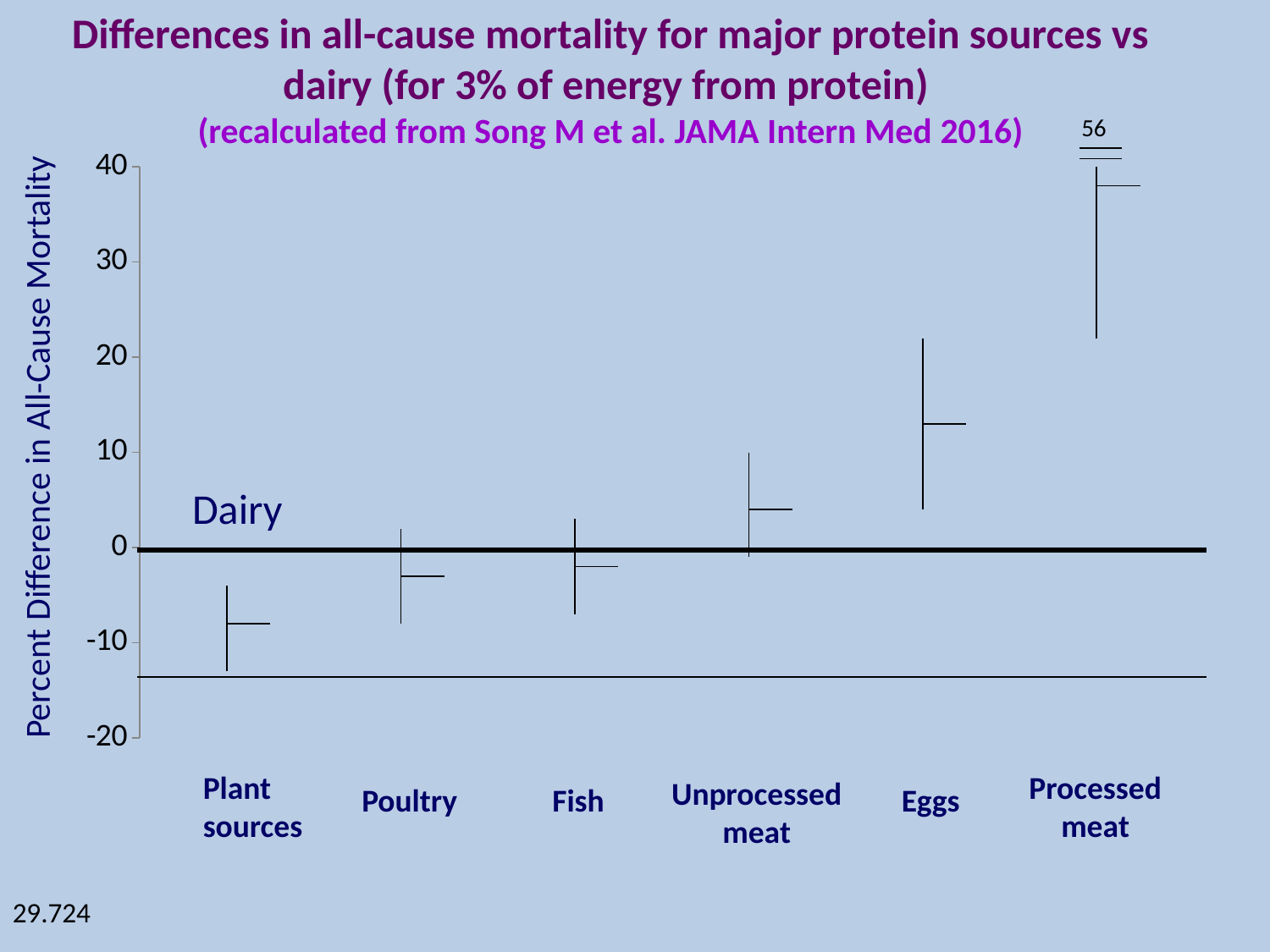
Do the values generally rise or fall moving from Plant sources to Processed meat along the x axis? rise What reference category is labelled on the thick horizontal line at 0? Dairy Is the value for Eggs greater or less than 10? greater What is the label on the y axis of the chart? Percent Difference in All-Cause Mortality Which protein source has the lowest percent difference in all-cause mortality? Plant sources Is the value for Plant sources greater or less than 0? less Is the value for Unprocessed meat greater or less than 0? greater Which protein source has the highest percent difference in all-cause mortality? Processed meat What number is printed at the top of the Processed meat error bar? 56 Which has a larger percent difference in all-cause mortality, Eggs or Fish? Eggs How many protein source categories are shown on the x axis of the chart? 6